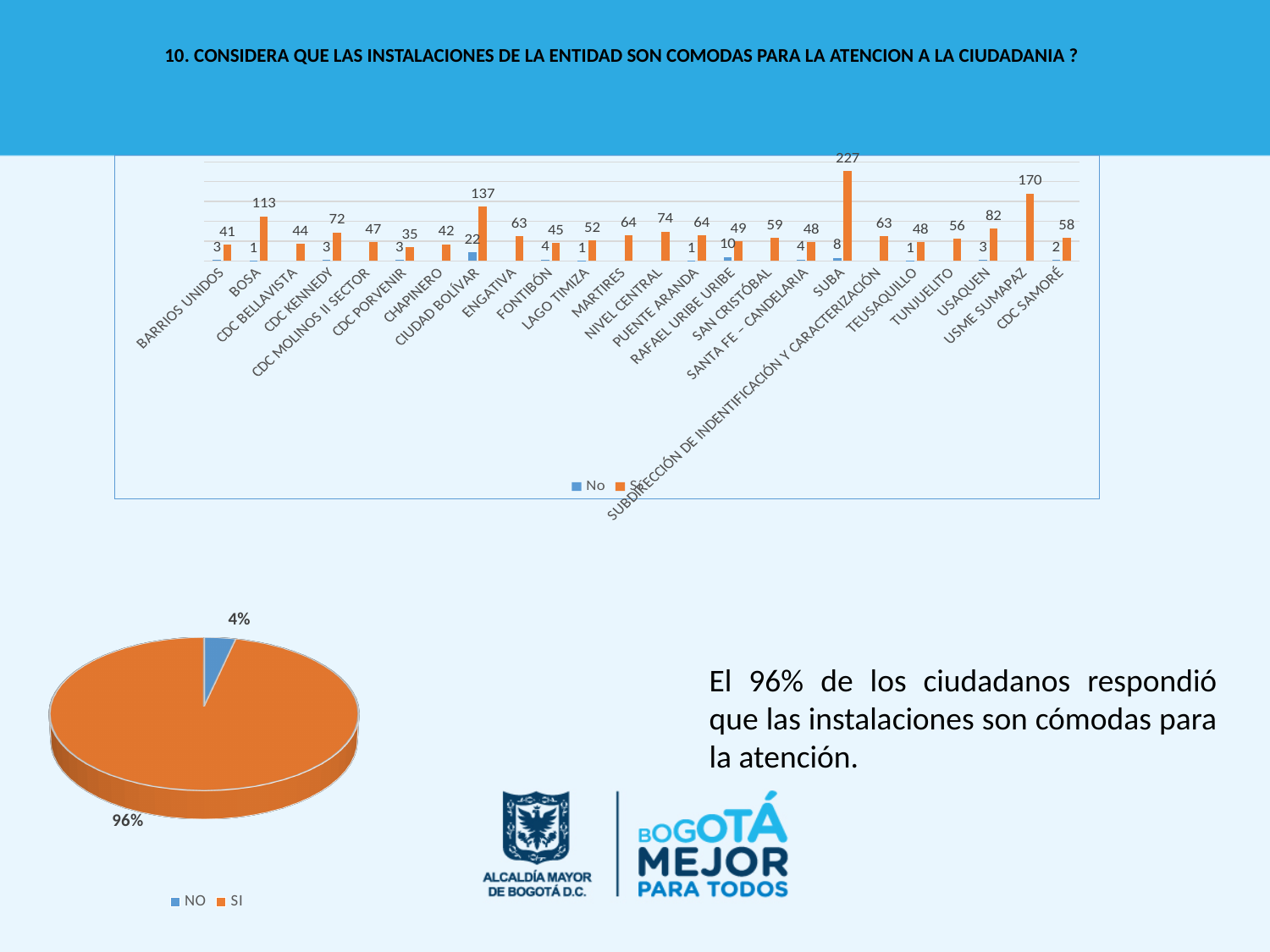
In the top bar chart, which category has the lowest 'Si' value? CDC PORVENIR In the top bar chart, what is the 'Si' value for CIUDAD BOLÍVAR? 137 In the top bar chart, what is the 'No' value for RAFAEL URIBE URIBE? 10 In the top bar chart, which has a larger 'Si' value, BOSA or CIUDAD BOLÍVAR? CIUDAD BOLÍVAR In the top bar chart, what is the 'Si' value for SUBA? 227 In the top bar chart, what is the difference between the 'Si' values for SUBA and USME SUMAPAZ? 57 In the top bar chart, which category has the highest 'Si' value? SUBA In the bottom-left pie chart, what share of the pie is 'NO'? 4% In the bottom-left pie chart, what share of the pie is 'SI'? 96% What kind of chart is the top chart on the slide? Bar chart How many categories are shown on the x axis of the top bar chart? 24 How many series does the legend of the top chart list? 2